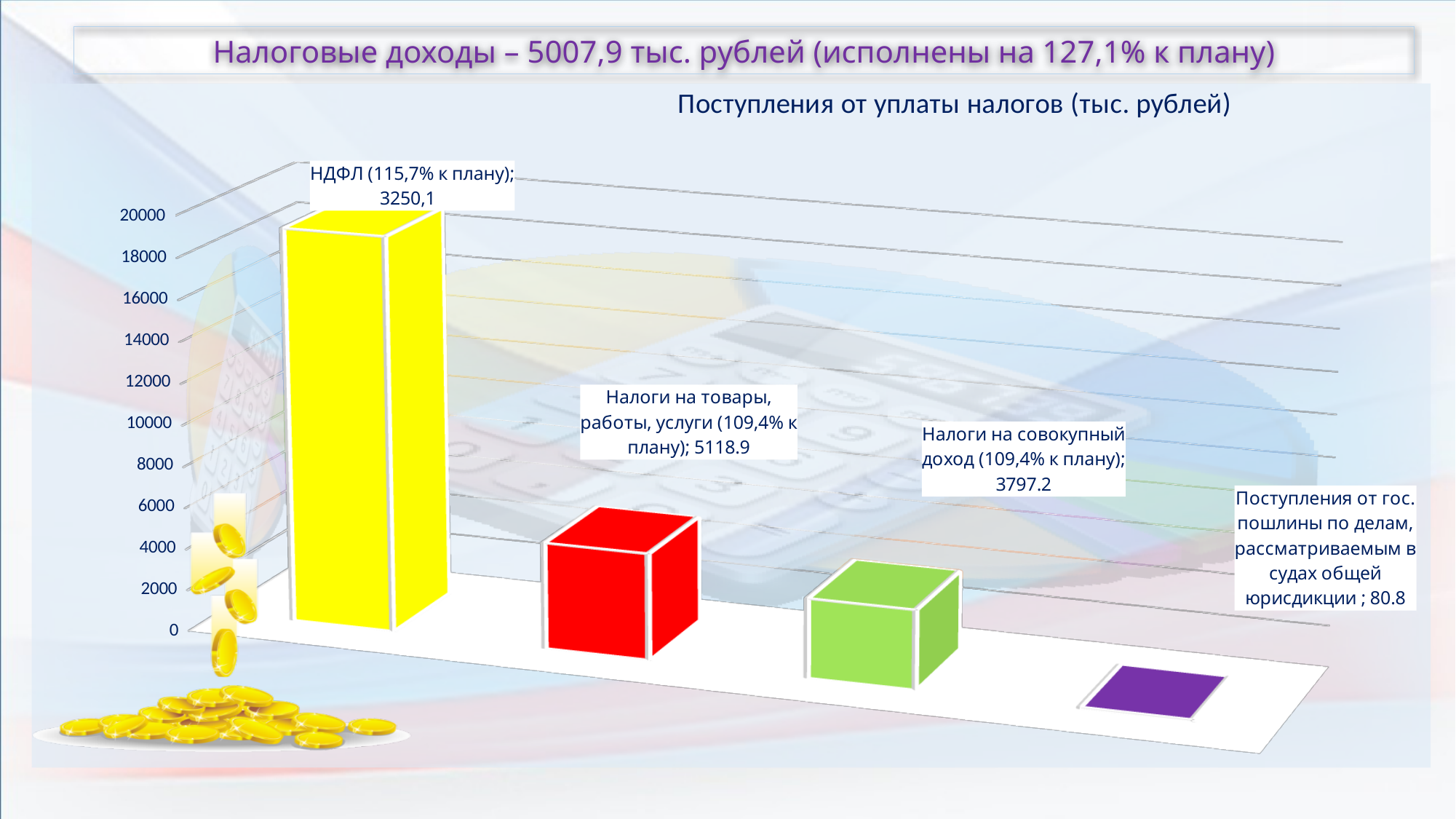
What is the title of the chart? Поступления от уплаты налогов (тыс. рублей) What value is labelled for Налоги на товары, работы, услуги? 5118.9 What is the difference between the labelled values for Налоги на товары, работы, услуги and Налоги на совокупный доход? 1321.7 What percentage of plan is shown for НДФЛ? 115,7% How many categories (bars) does the chart show? 4 Is the bar for Поступления от гос. пошлины greater or less than 2000 on the axis? less What value is labelled for Поступления от гос. пошлины по делам, рассматриваемым в судах общей юрисдикции? 80.8 What value is labelled for НДФЛ? 3250,1 What value is labelled for Налоги на совокупный доход? 3797.2 Which labelled value is larger: Налоги на товары, работы, услуги or Налоги на совокупный доход? Налоги на товары, работы, услуги What kind of chart is shown on the slide? bar chart Which category has the shortest bar? Поступления от гос. пошлины по делам, рассматриваемым в судах общей юрисдикции